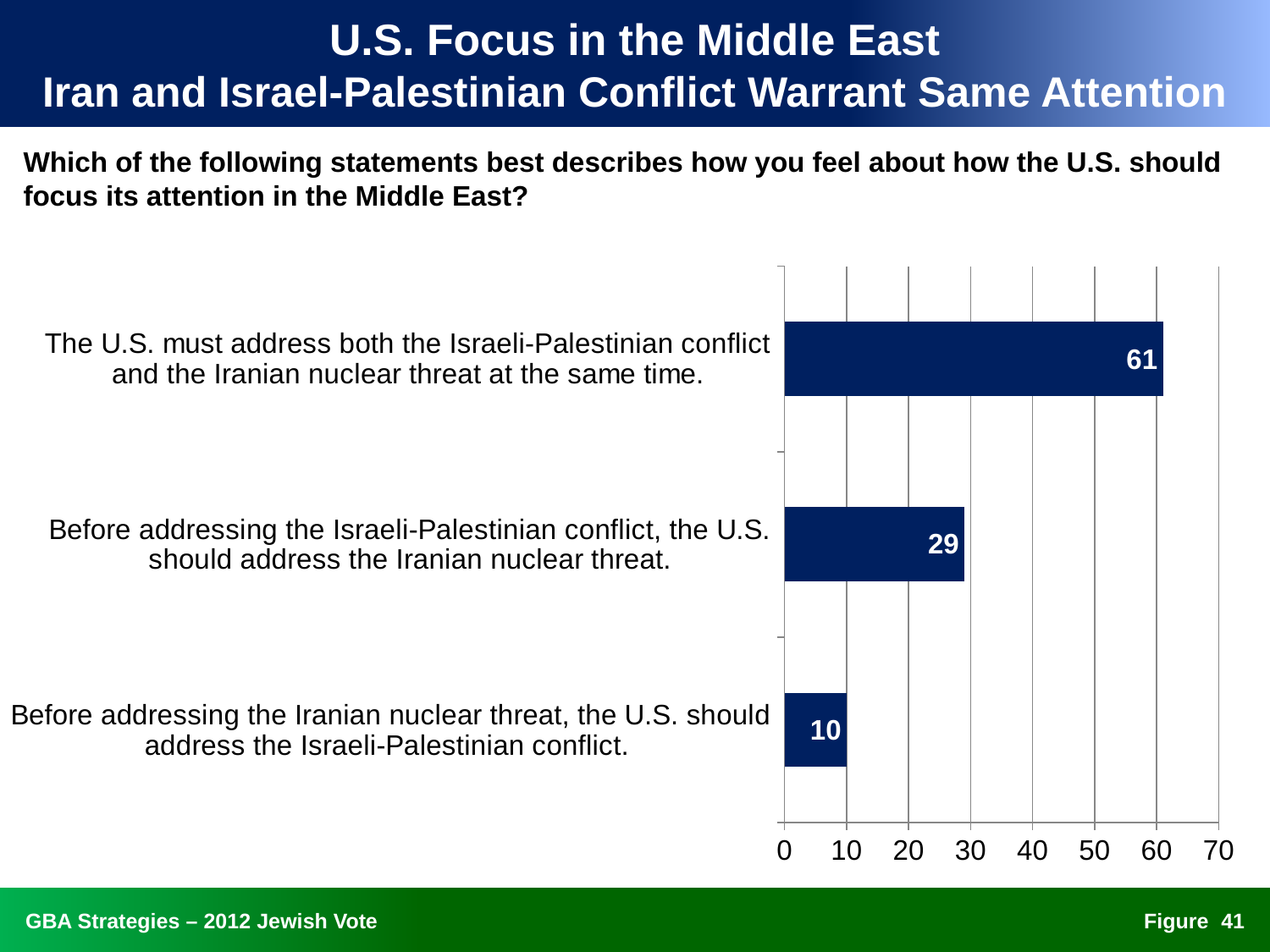
What value is shown for the statement that before addressing the Iranian nuclear threat, the U.S. should address the Israeli-Palestinian conflict? 10 Which is larger: the value for addressing the Iranian nuclear threat first or the value for addressing the Israeli-Palestinian conflict first? Addressing the Iranian nuclear threat first What value is shown for the statement that the U.S. must address both the Israeli-Palestinian conflict and the Iranian nuclear threat at the same time? 61 Is the value for addressing both at the same time greater or less than 50? greater What is the difference between the value for addressing both at the same time and the value for addressing the Iranian nuclear threat first? 32 What kind of chart is shown on the slide? Bar chart What is the maximum value shown on the horizontal axis? 70 Which statement has the highest value? The U.S. must address both the Israeli-Palestinian conflict and the Iranian nuclear threat at the same time. What value is shown for the statement that before addressing the Israeli-Palestinian conflict, the U.S. should address the Iranian nuclear threat? 29 Which statement has the lowest value? Before addressing the Iranian nuclear threat, the U.S. should address the Israeli-Palestinian conflict. What is the difference between the value for addressing the Iranian nuclear threat first and the value for addressing the Israeli-Palestinian conflict first? 19 How many statements are shown in the chart? 3